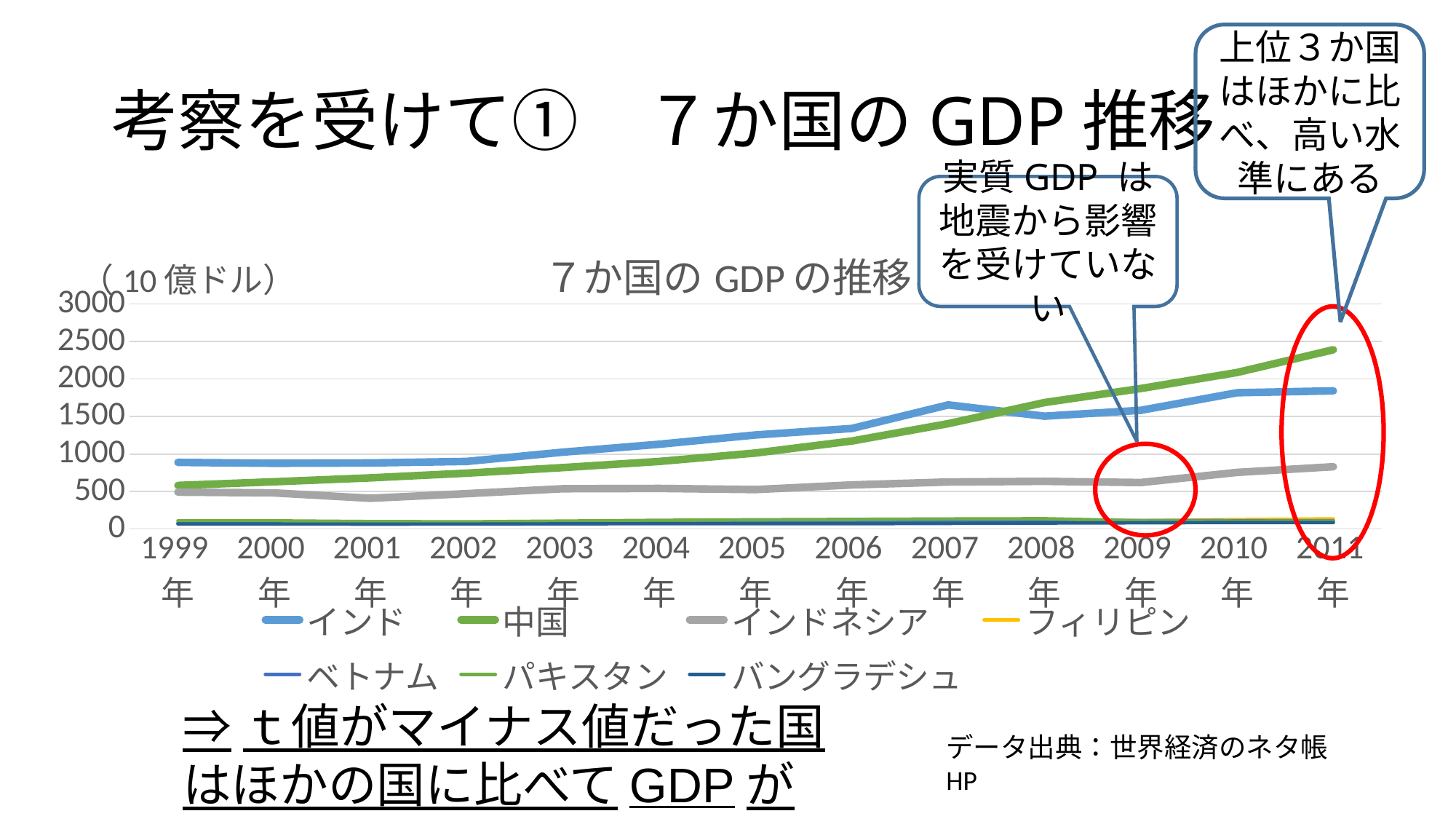
Which is larger in 2011, the value for 中国 or the value for インド? 中国 Is the value for インド in 2011 greater or less than 1500? greater What kind of chart is shown on the slide? line chart How many years are plotted along the x axis? 13 Is the value for 中国 in 2011 greater or less than 2000? greater Is the value for インドネシア in 2011 greater or less than 1000? less Which country has the highest GDP in 2011? 中国 How many series does the legend list? 7 Does the line for 中国 rise or fall from 1999 to 2011? rise Which is larger in 1999, the value for インド or the value for 中国? インド What is the title of the chart? ７か国の GDP の推移